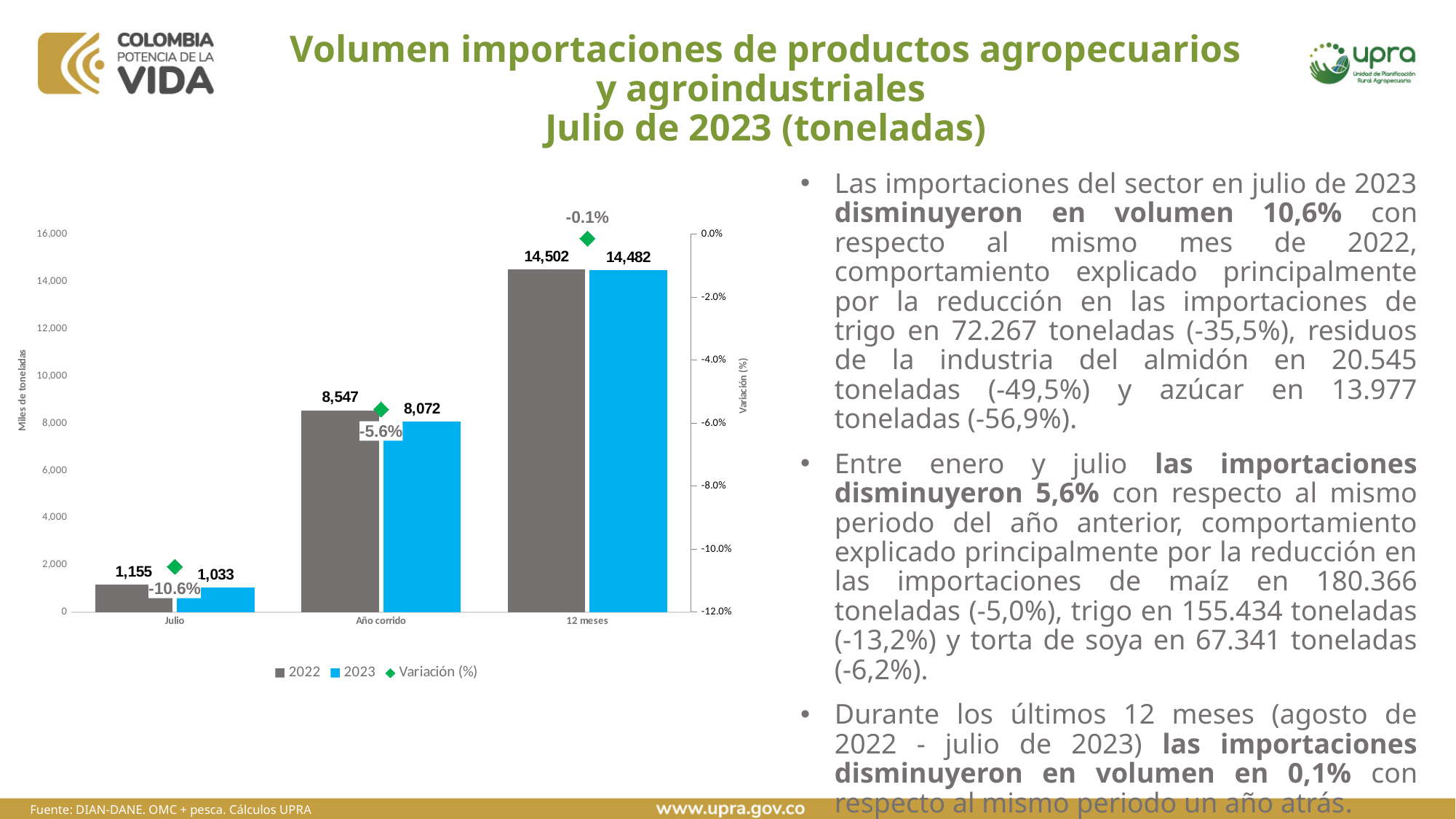
What is the Variación (%) value for Julio? -10.6% Which category has the lowest 2022 value? Julio How many categories are shown on the x axis? 3 What kind of chart is shown on the slide? Bar chart with a marker series What is the 2022 value for Julio? 1,155 What is the difference between the 2022 and 2023 values for Año corrido? 475 What is the label of the left vertical axis? Miles de toneladas Which is larger for Julio, the 2022 value or the 2023 value? 2022 What is the 2023 value for Año corrido? 8,072 What is the Variación (%) value for 12 meses? -0.1% How many series does the legend list? 3 Which category has the highest 2023 value? 12 meses